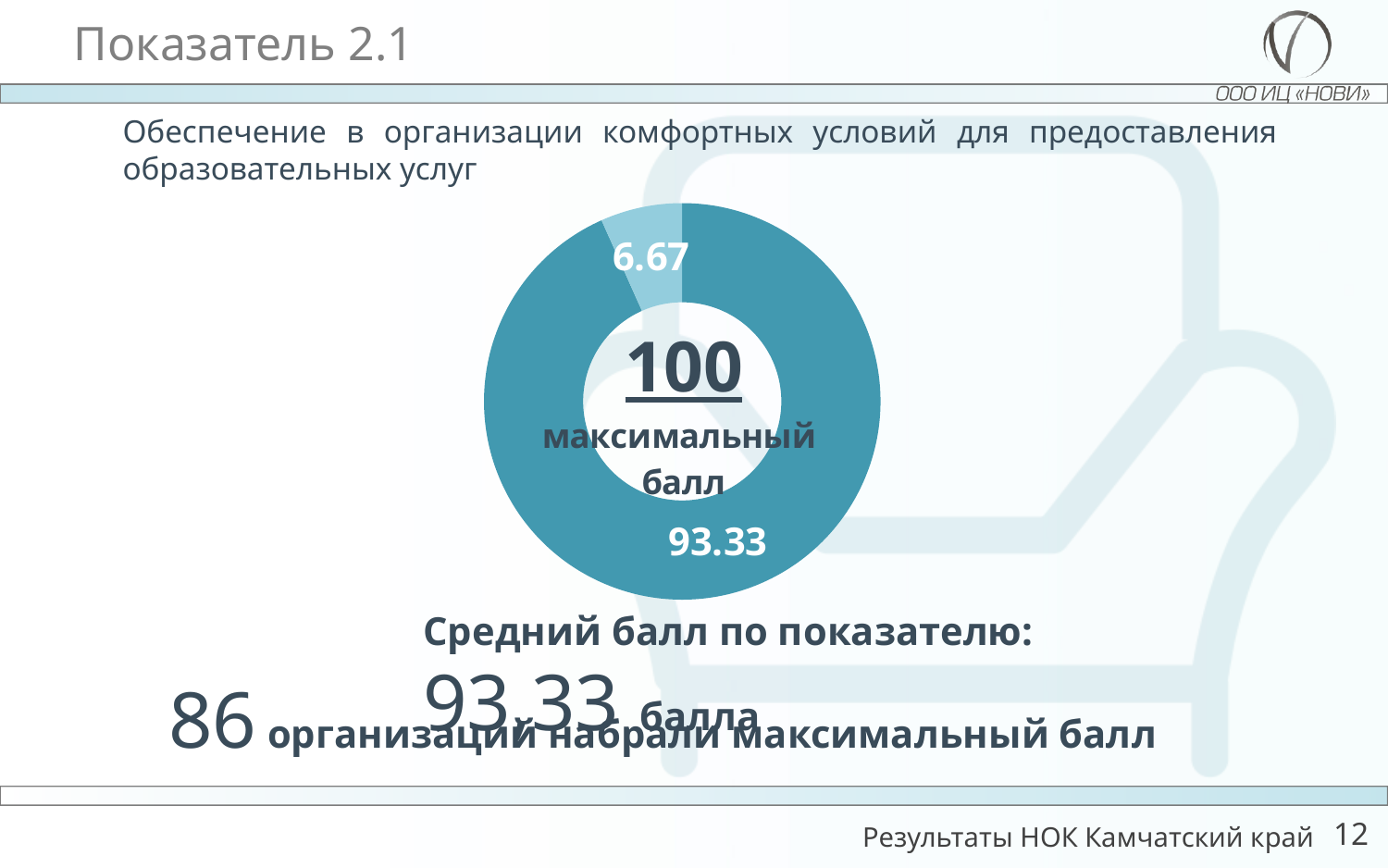
What is the difference between the two slice values on the donut chart (93.33 and 6.67)? 86.66 What value is labelled on the small light teal slice of the donut chart? 6.67 What is the smallest value shown on the donut chart? 6.67 What text appears below the number in the centre of the donut chart? максимальный балл Which slice is larger: the one labelled 93.33 or the one labelled 6.67? 93.33 What kind of chart is shown on the slide? pie chart (donut) What number is written in the centre of the donut chart? 100 How many slices does the donut chart have? 2 What is the total of the two slice values on the donut chart? 100 What is the largest value shown on the donut chart? 93.33 What share of the whole donut does the slice labelled 93.33 represent? 93.33% What value is labelled on the large dark teal slice of the donut chart? 93.33